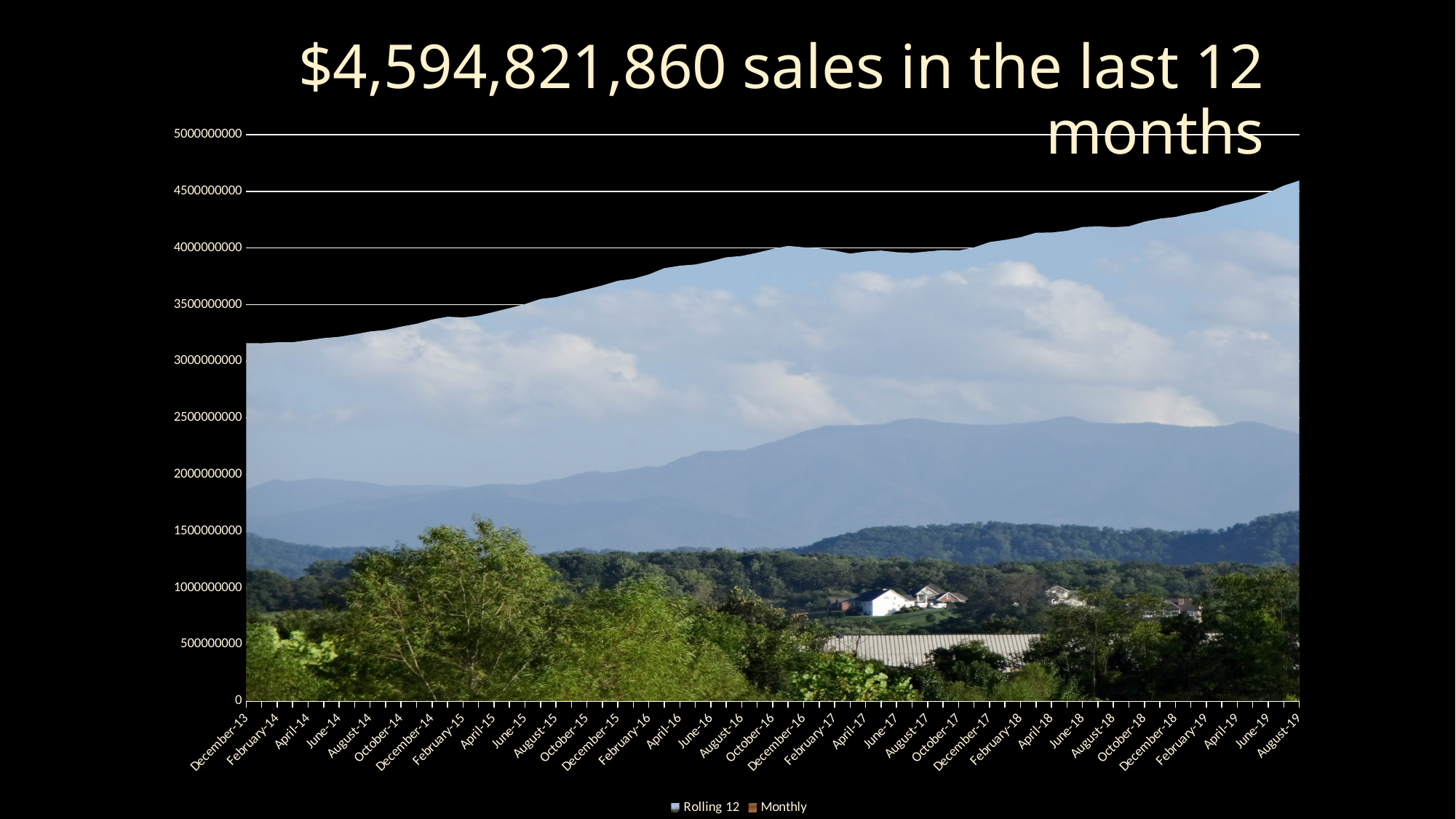
How many series does the legend list? 2 Is the Rolling 12 value for December-13 greater or less than 3500000000? less What kind of chart is shown on the slide? area chart Does the Rolling 12 series generally rise or fall from December-13 to August-19? rise Is the Rolling 12 value for December-13 greater or less than 3000000000? greater Is the Rolling 12 value for December-14 greater or less than 3500000000? less What are the two series named in the legend? Rolling 12 and Monthly Which month has the highest Rolling 12 value, December-13 or August-19? August-19 What is the title of the chart? $4,594,821,860 sales in the last 12 months